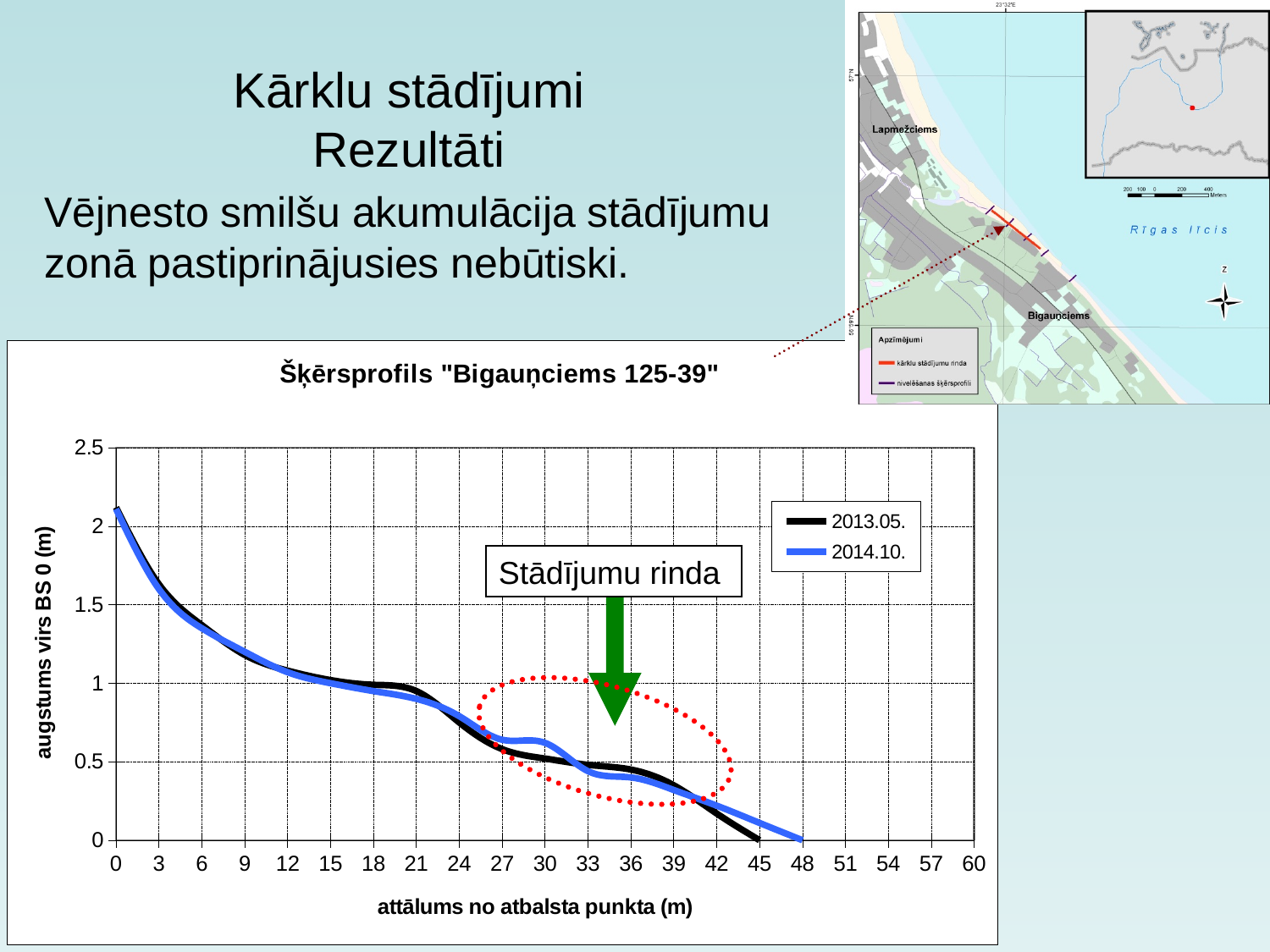
At what distance (m) does the 2013.05. line reach a height of 0? 45 What is the title of the chart? Šķērsprofils "Bigauņciems 125-39" Is the height for the 2013.05. series at a distance of 12 m greater or less than 1? greater At what distance (m) does the 2014.10. line reach a height of 0? 48 At a distance of 30 m, which series shows the greater height, 2013.05. or 2014.10.? 2014.10. How many series does the chart legend list? 2 Is the height for the 2014.10. series at a distance of 0 m greater or less than 2? greater Which series is drawn in blue in the chart? 2014.10. Is the height for the 2014.10. series at a distance of 39 m greater or less than 0.5? less At a distance of 45 m, which series shows the greater height, 2013.05. or 2014.10.? 2014.10. Do the values of the 2013.05. series rise or fall as the distance along the x axis increases? fall What kind of chart is shown on the slide? line chart